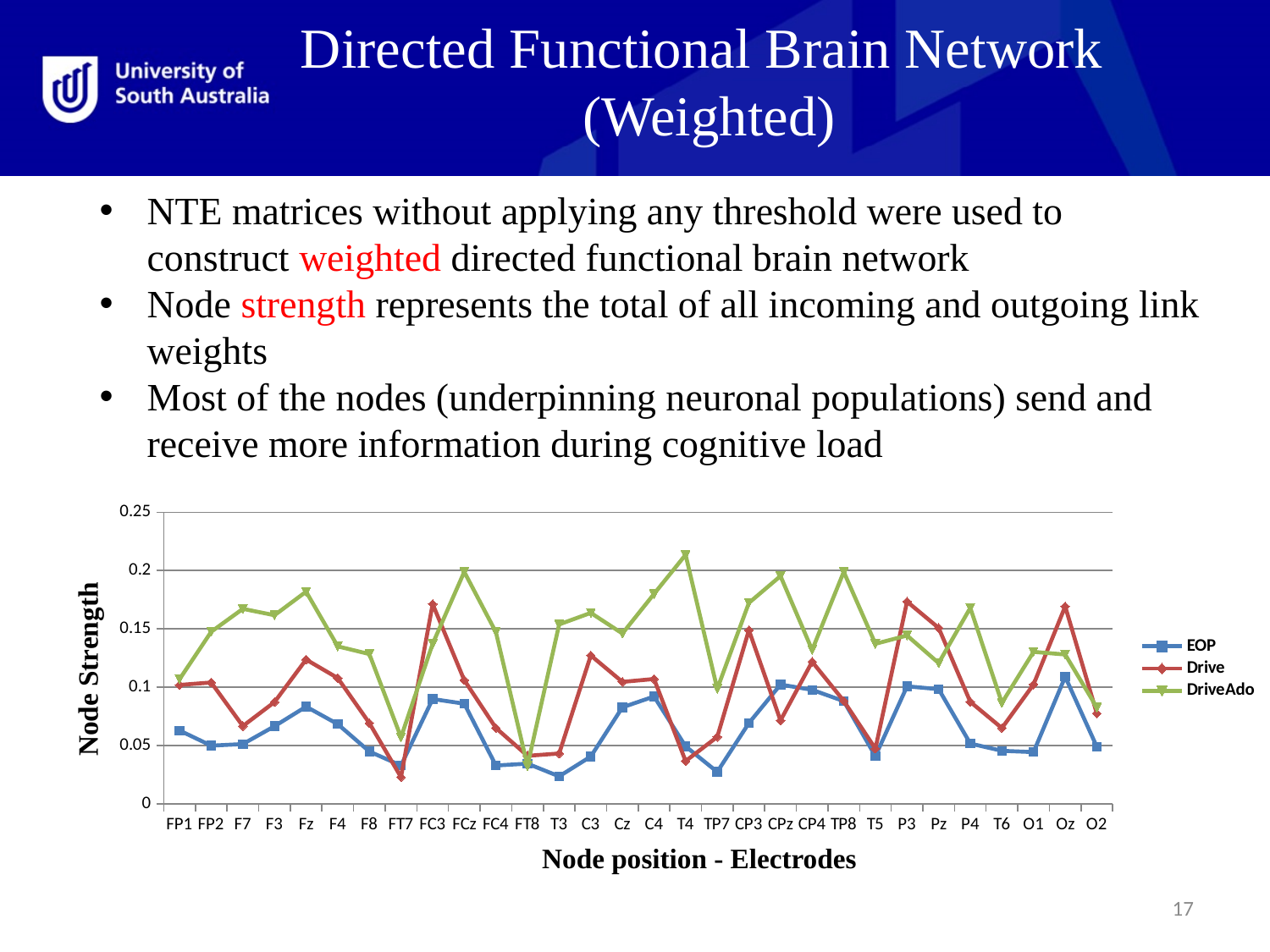
At which electrode does the DriveAdo series reach its highest value? T4 How many electrode positions are plotted along the x axis? 30 What kind of chart is shown on the slide? line chart Is the Drive value at FT7 greater or less than 0.05? less What is the title of the y axis? Node Strength Is the DriveAdo value at FCz greater or less than 0.15? greater How many series does the legend list? 3 At T4, which series has the larger value, DriveAdo or EOP? DriveAdo Is the DriveAdo value at T4 greater or less than 0.2? greater At FC3, which series has the larger value, Drive or EOP? Drive At which electrode does the Drive series reach its lowest value? FT7